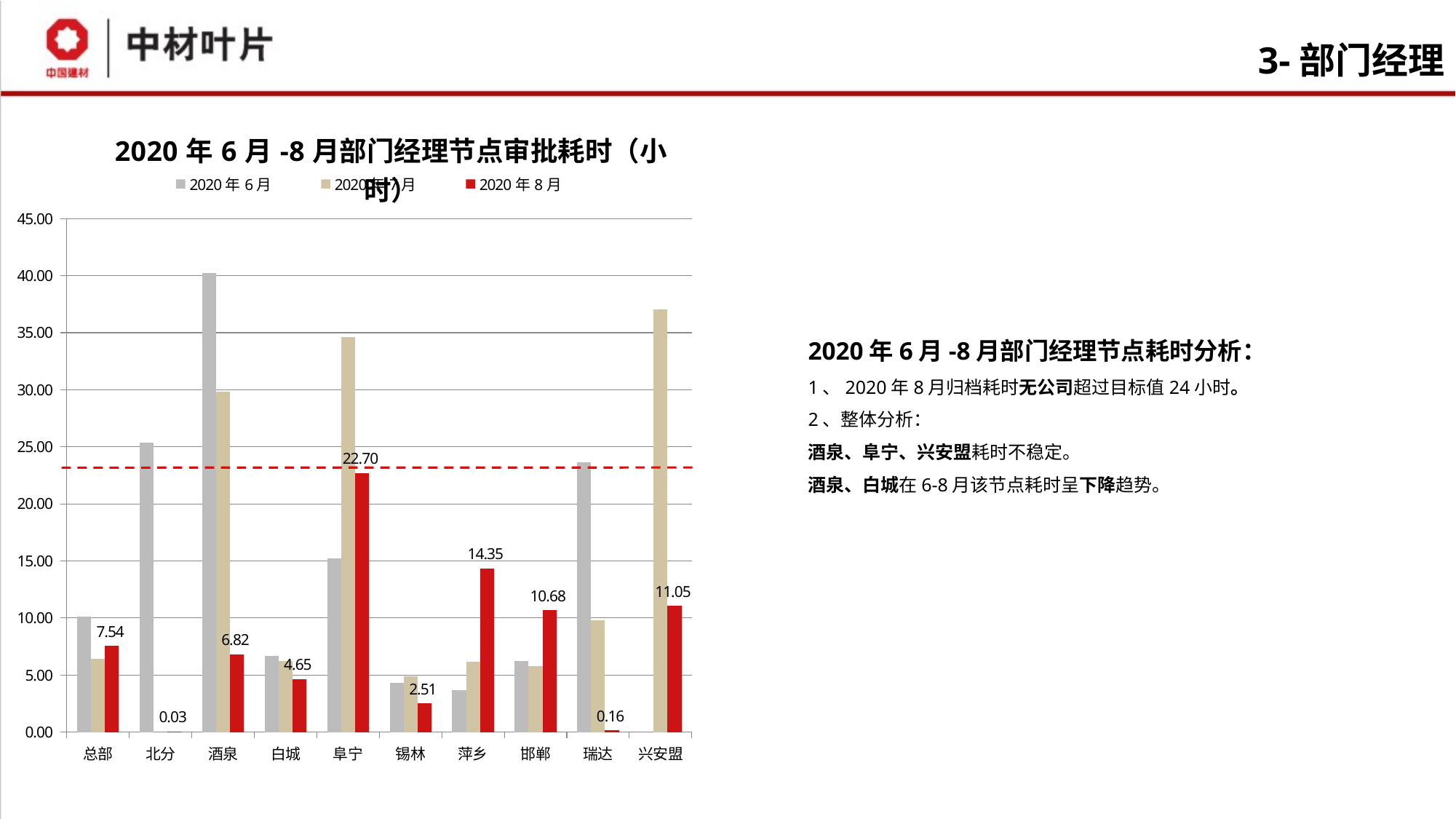
What is the value for 萍乡 in the 2020年8月 series? 14.35 How many categories are shown on the x axis of the chart? 10 What is the value for 瑞达 in the 2020年8月 series? 0.16 How many series does the chart legend list? 3 Which category has the lowest value in the 2020年8月 series? 北分 Which category has the highest value in the 2020年8月 series? 阜宁 What is the value for 阜宁 in the 2020年8月 series? 22.70 In the 2020年8月 series, which is larger: 邯郸 or 兴安盟? 兴安盟 What is the difference between the 2020年8月 values for 邯郸 and 酒泉? 3.86 What is the difference between the 2020年8月 values for 阜宁 and 萍乡? 8.35 Is the value for 兴安盟 in the 2020年7月 series greater or less than 35.00? greater Is the value for 酒泉 in the 2020年6月 series greater or less than 35.00? greater